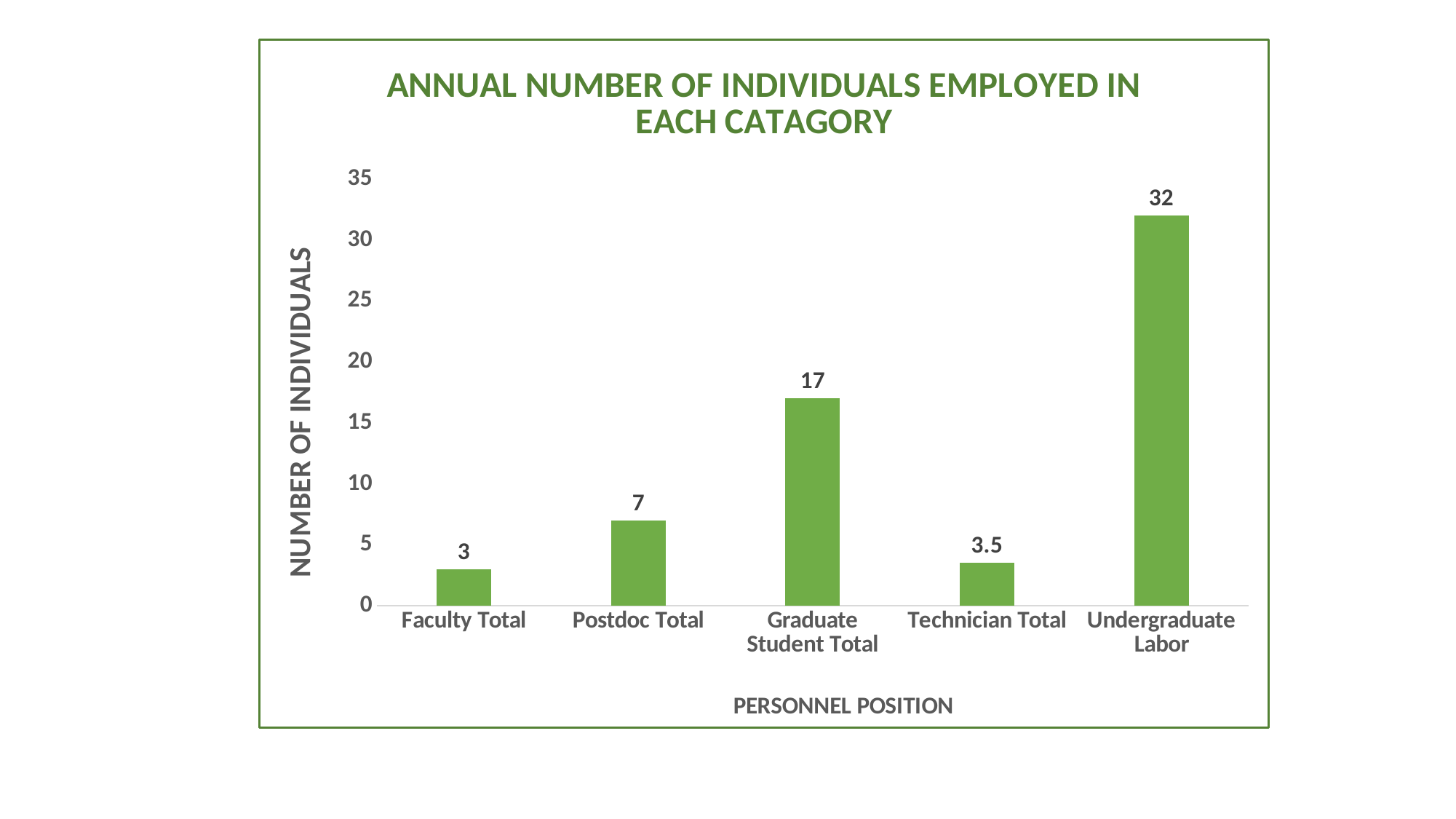
What is the title of the chart? ANNUAL NUMBER OF INDIVIDUALS EMPLOYED IN EACH CATAGORY What is the value for Faculty Total? 3 What is the value for Graduate Student Total? 17 What is the value for Technician Total? 3.5 Which category has the highest value? Undergraduate Labor What is the value for Postdoc Total? 7 Which category has the lowest value? Faculty Total What is the difference between the values for Undergraduate Labor and Graduate Student Total? 15 What kind of chart is shown on the slide? Bar chart Which is larger, the value for Postdoc Total or the value for Technician Total? Postdoc Total What is the value for Undergraduate Labor? 32 How many categories are shown on the x axis? 5